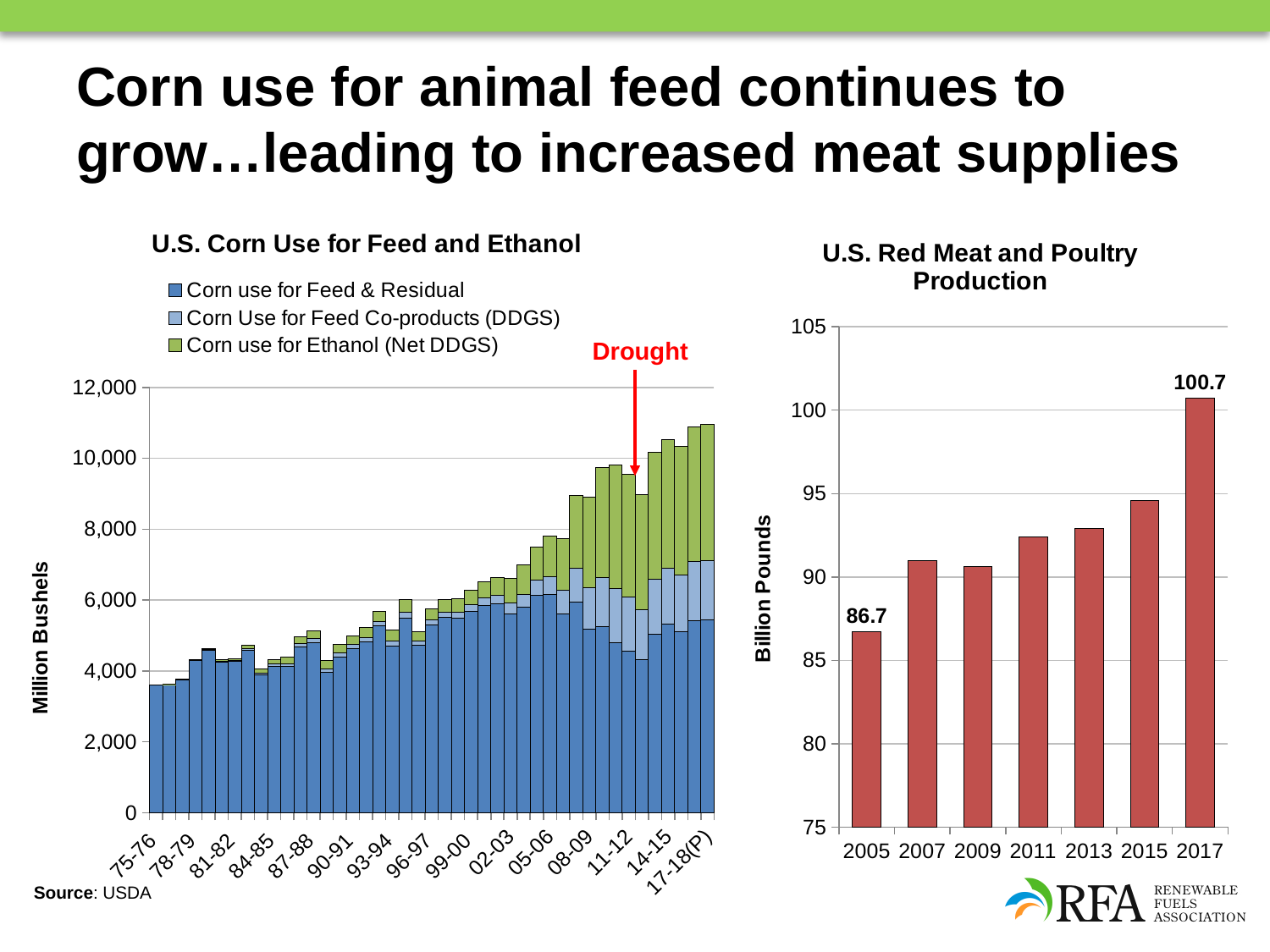
In the U.S. Corn Use for Feed and Ethanol chart, what is the y-axis label? Million Bushels In the U.S. Corn Use for Feed and Ethanol chart, how many series does the legend list? 3 What kind of chart is the U.S. Corn Use for Feed and Ethanol chart? stacked bar chart In the U.S. Red Meat and Poultry Production chart, what is the value for 2005? 86.7 In the U.S. Red Meat and Poultry Production chart, how many years are plotted? 7 In the U.S. Red Meat and Poultry Production chart, which year has the highest production? 2017 In the U.S. Red Meat and Poultry Production chart, do values generally rise or fall from 2005 to 2017? rise In the U.S. Red Meat and Poultry Production chart, is the value for 2011 greater or less than 90? greater In the U.S. Red Meat and Poultry Production chart, what is the difference between the 2017 and 2005 values? 14.0 In the U.S. Red Meat and Poultry Production chart, is the value for 2009 greater or less than 95? less In the U.S. Red Meat and Poultry Production chart, what is the value for 2017? 100.7 In the U.S. Red Meat and Poultry Production chart, which year has the lowest production? 2005